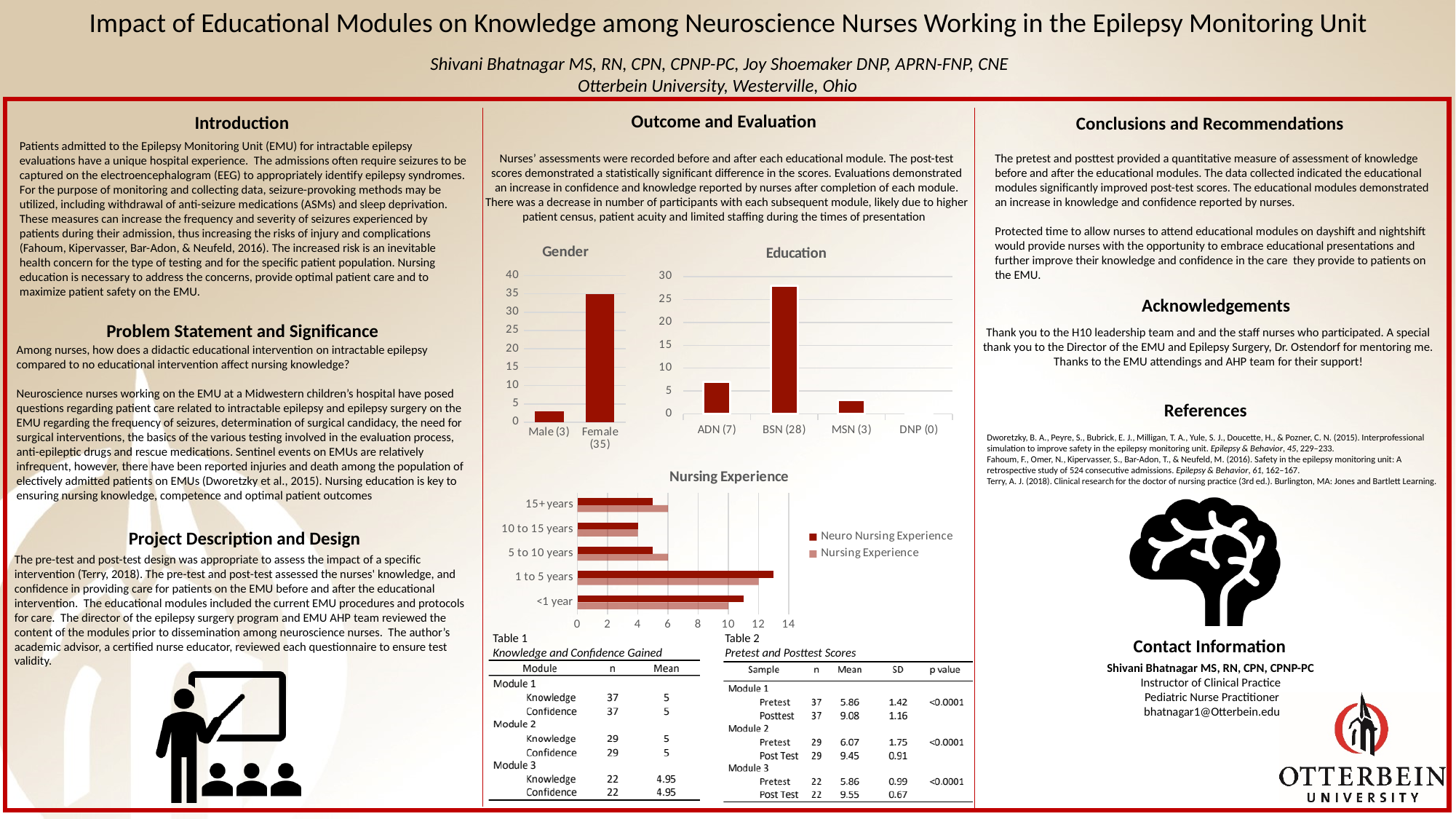
In the Education chart, which category has the lowest value? DNP What kind of chart is the Nursing Experience chart? Bar chart In the Gender chart, what is the difference between the Female and Male values? 32 In the Nursing Experience chart, is the Neuro Nursing Experience value for 1 to 5 years greater or less than 10? greater In the Nursing Experience chart, how many series does the legend list? 2 In the Gender chart, what is the value for Female? 35 In the Education chart, how many categories are shown? 4 In the Education chart, which is larger, ADN or MSN? ADN In the Education chart, what is the difference between the BSN and ADN values? 21 In the Gender chart, which category has the highest value? Female In the Gender chart, how many categories are shown? 2 In the Education chart, what is the value for BSN? 28